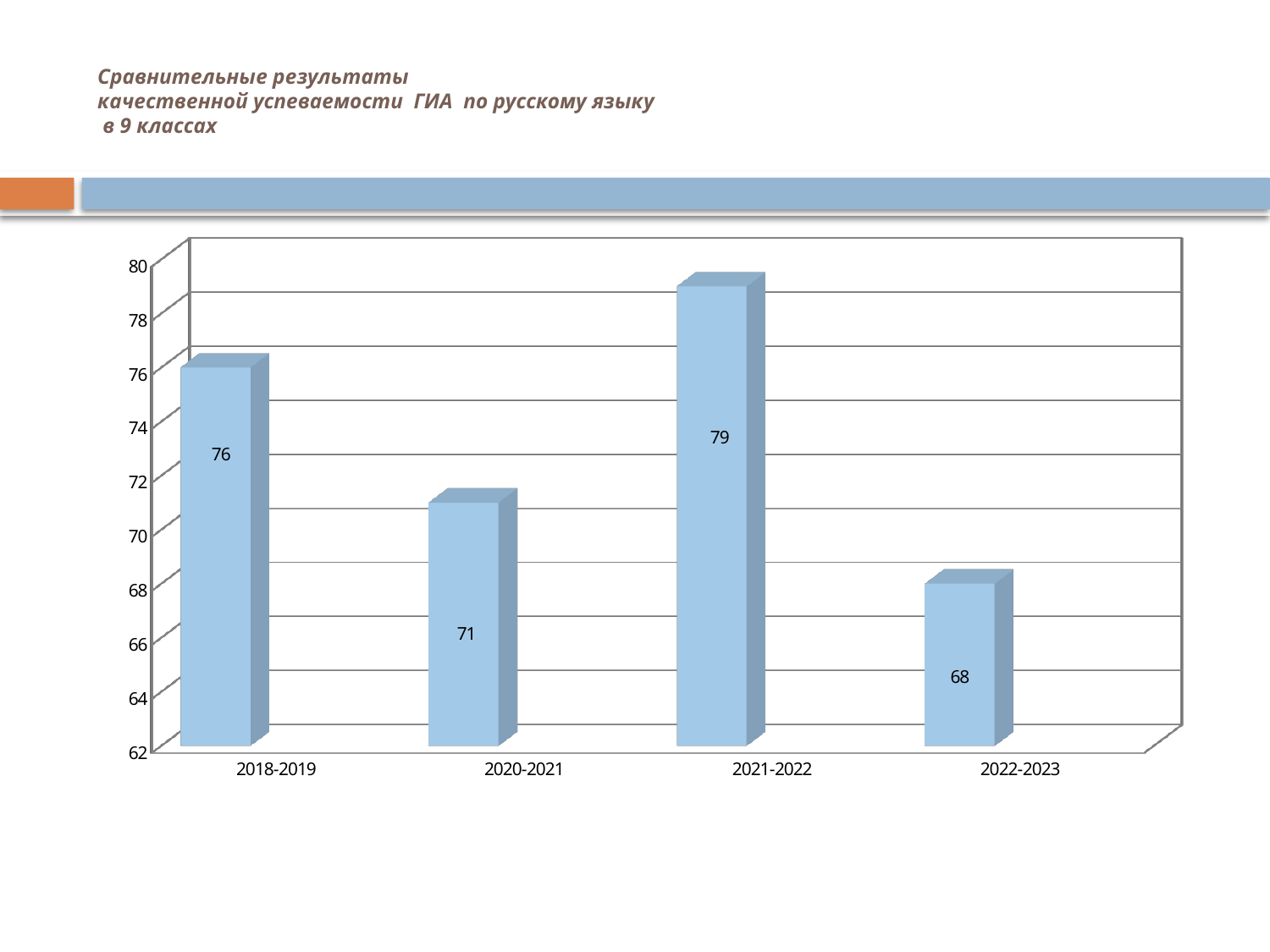
Which is larger, the value for 2018-2019 or the value for 2020-2021? 2018-2019 What is the value for 2022-2023? 68 Which academic year has the highest value? 2021-2022 How many academic years are shown on the x axis? 4 What is the difference between the values for 2018-2019 and 2020-2021? 5 What is the difference between the values for 2021-2022 and 2022-2023? 11 What is the value for 2018-2019? 76 Is the value for 2022-2023 greater or less than 70? less Which academic year has the lowest value? 2022-2023 What is the value for 2020-2021? 71 What is the value for 2021-2022? 79 What kind of chart is shown on the slide? bar chart